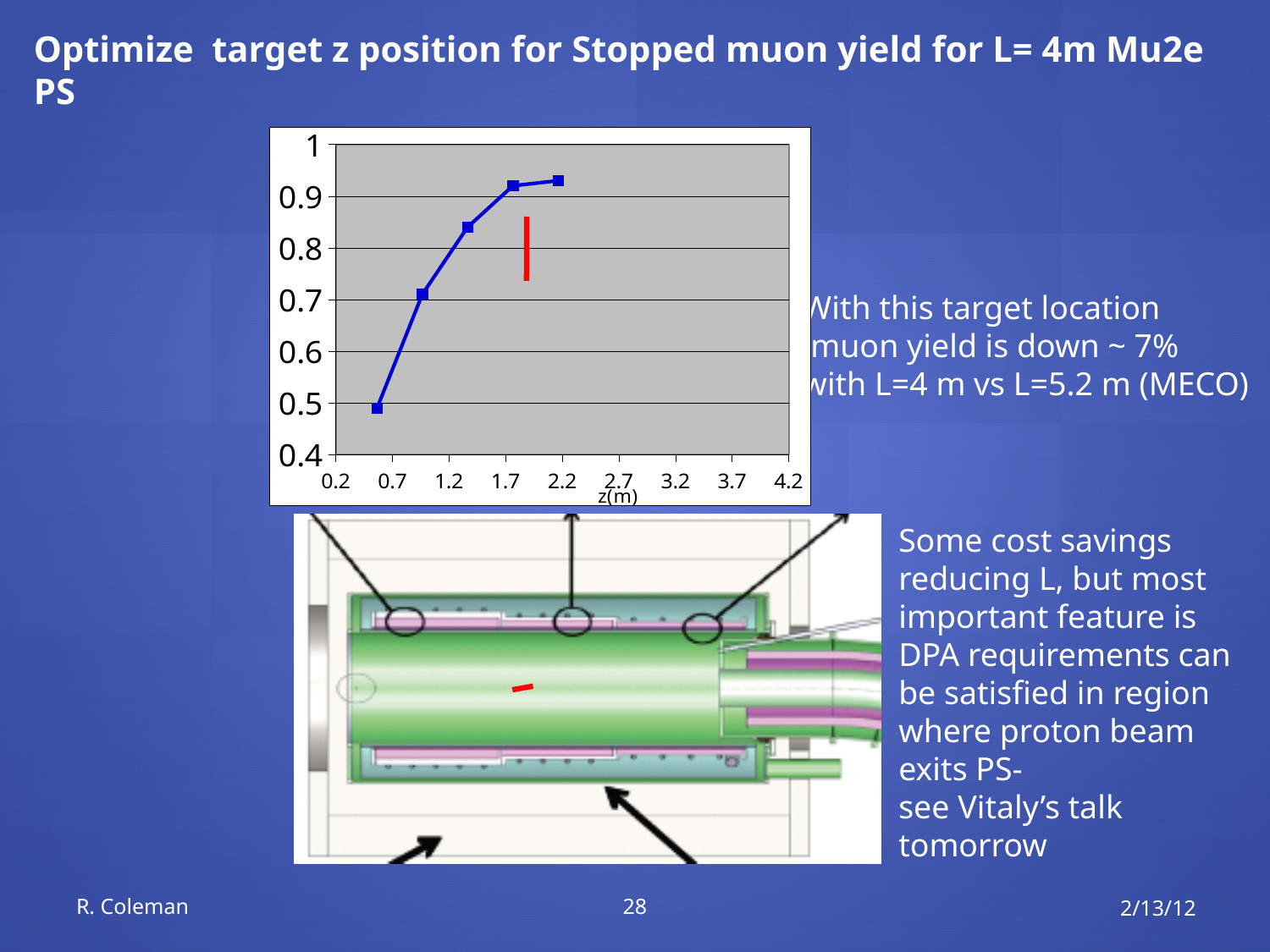
Is the value of the third data point from the left greater or less than 0.8? greater What kind of chart is shown on the slide? line chart How many data points are plotted on the chart? 5 Is the value of the third data point from the left larger or smaller than the value of the leftmost point? larger What is the highest tick value shown on the y axis of the chart? 1 What is the label on the x axis of the chart? z(m) Is the value of the leftmost data point greater or less than 0.6? less Is the value of the second data point from the left greater or less than 0.6? greater Which plotted point has the lowest value, the leftmost or the rightmost? leftmost Do the plotted values rise or fall as z increases along the x axis? rise